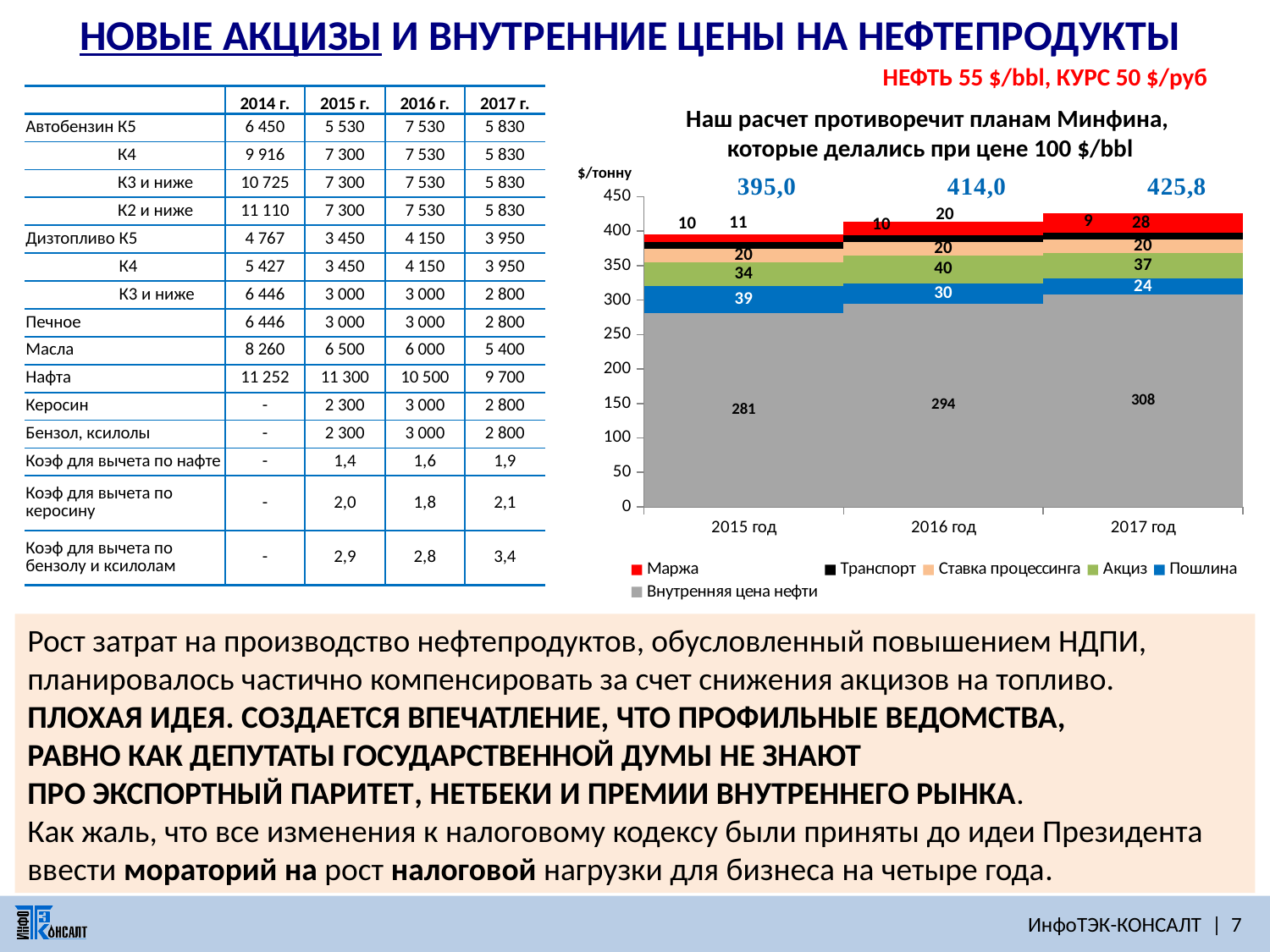
What is the value of Пошлина for 2015 год? 39 What is the difference between the Внутренняя цена нефти values for 2017 год and 2015 год? 27 Does the total of the stacked bars rise or fall from 2015 год to 2017 год? rise What is the total printed above the stacked bar for 2017 год? 425,8 What is the value of Внутренняя цена нефти for 2016 год? 294 What is the value of Акциз for 2017 год? 37 Which is larger: the Пошлина value for 2015 год or for 2017 год? 2015 год How many years (categories) are shown on the x axis of the chart? 3 In which year is the total of the stacked bar the lowest? 2015 год In which year is the Акциз value the highest? 2016 год How many series does the chart legend list? 6 What kind of chart is shown on the slide? stacked bar chart